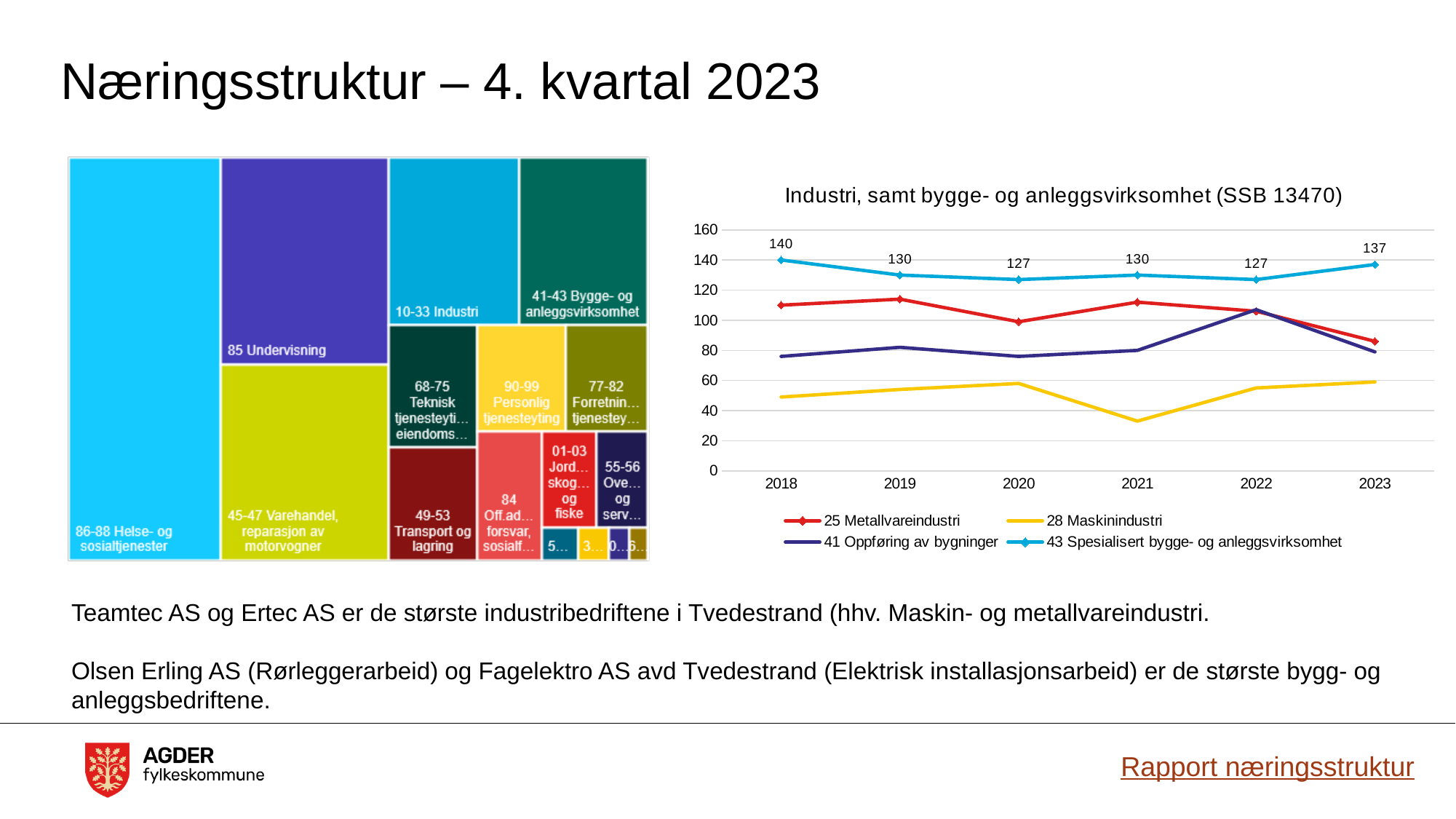
In the chart titled 'Industri, samt bygge- og anleggsvirksomhet (SSB 13470)', is the value for 28 Maskinindustri in 2021 greater or less than 40? less In the chart titled 'Industri, samt bygge- og anleggsvirksomhet (SSB 13470)', is the value for 25 Metallvareindustri in 2019 greater or less than 100? greater In the chart titled 'Industri, samt bygge- og anleggsvirksomhet (SSB 13470)', what is the value for 43 Spesialisert bygge- og anleggsvirksomhet in 2018? 140 In the chart titled 'Industri, samt bygge- og anleggsvirksomhet (SSB 13470)', how many years are shown on the x axis? 6 In the chart titled 'Industri, samt bygge- og anleggsvirksomhet (SSB 13470)', which series has the lowest values across all years? 28 Maskinindustri In the chart titled 'Industri, samt bygge- og anleggsvirksomhet (SSB 13470)', what is the difference between the 2018 and 2023 values for 43 Spesialisert bygge- og anleggsvirksomhet? 3 What kind of chart is the one titled 'Industri, samt bygge- og anleggsvirksomhet (SSB 13470)'? Line chart In the chart titled 'Industri, samt bygge- og anleggsvirksomhet (SSB 13470)', in which year is the value for 43 Spesialisert bygge- og anleggsvirksomhet highest? 2018 In the chart titled 'Industri, samt bygge- og anleggsvirksomhet (SSB 13470)', how many series does the legend list? 4 In the chart titled 'Industri, samt bygge- og anleggsvirksomhet (SSB 13470)', what is the value for 43 Spesialisert bygge- og anleggsvirksomhet in 2023? 137 In the chart titled 'Industri, samt bygge- og anleggsvirksomhet (SSB 13470)', which is larger in 2023: 25 Metallvareindustri or 28 Maskinindustri? 25 Metallvareindustri In the chart titled 'Industri, samt bygge- og anleggsvirksomhet (SSB 13470)', what is the value for 43 Spesialisert bygge- og anleggsvirksomhet in 2020? 127